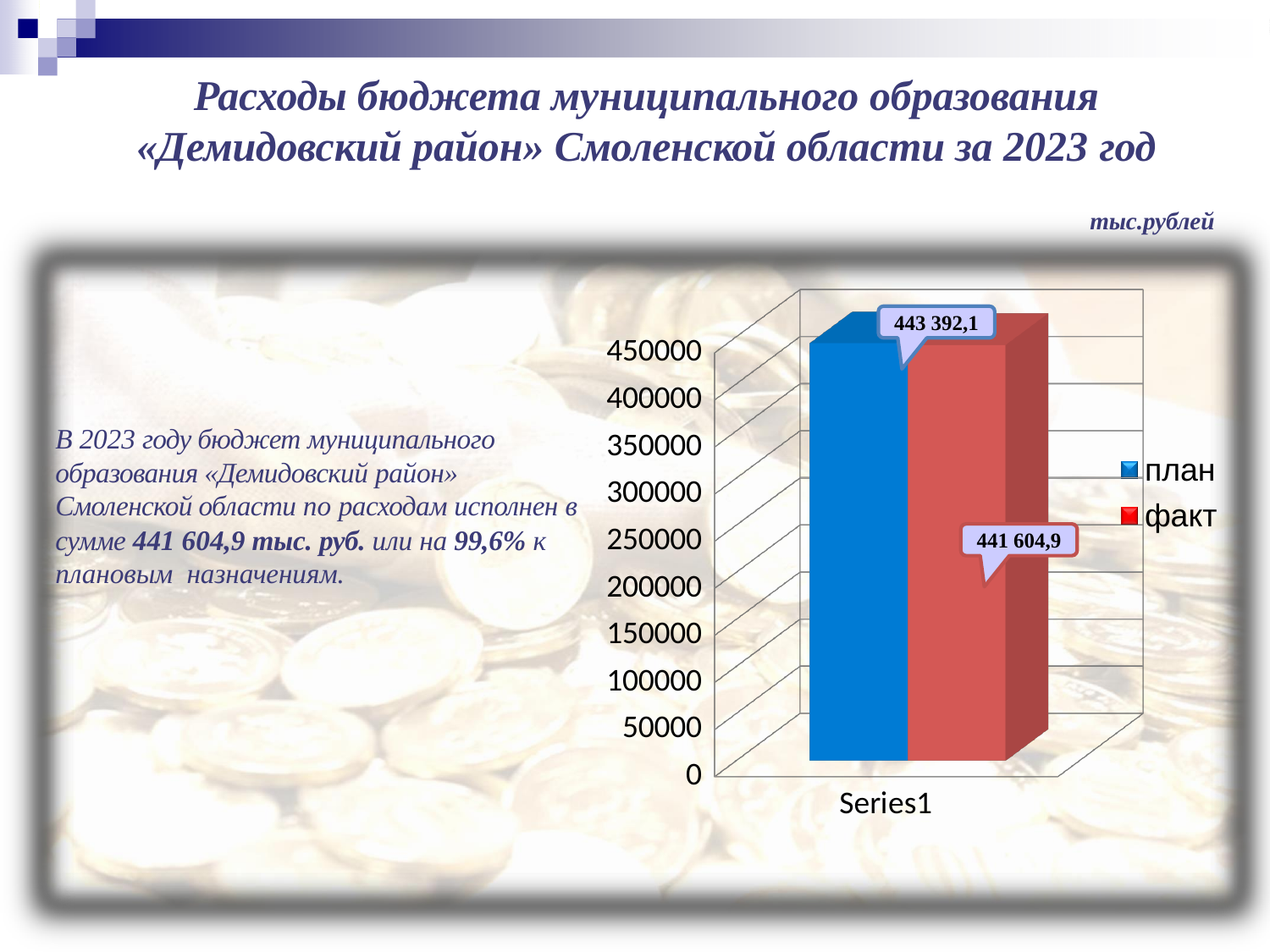
What is the highest tick value shown on the vertical axis? 450000 What kind of chart is shown on the slide? bar chart How many categories are shown on the x axis? 1 What is the difference between the план value and the факт value? 1 787,2 What unit is stated above the chart? тыс.рублей Is the value for факт greater or less than 400000? greater Which series has the higher value according to the data labels, план or факт? план What is the value of the план (plan) bar? 443 392,1 How many series does the legend list? 2 Is the value for план greater or less than 350000? greater What is the value of the факт (actual) bar? 441 604,9 What colour is the факт series in the chart? red